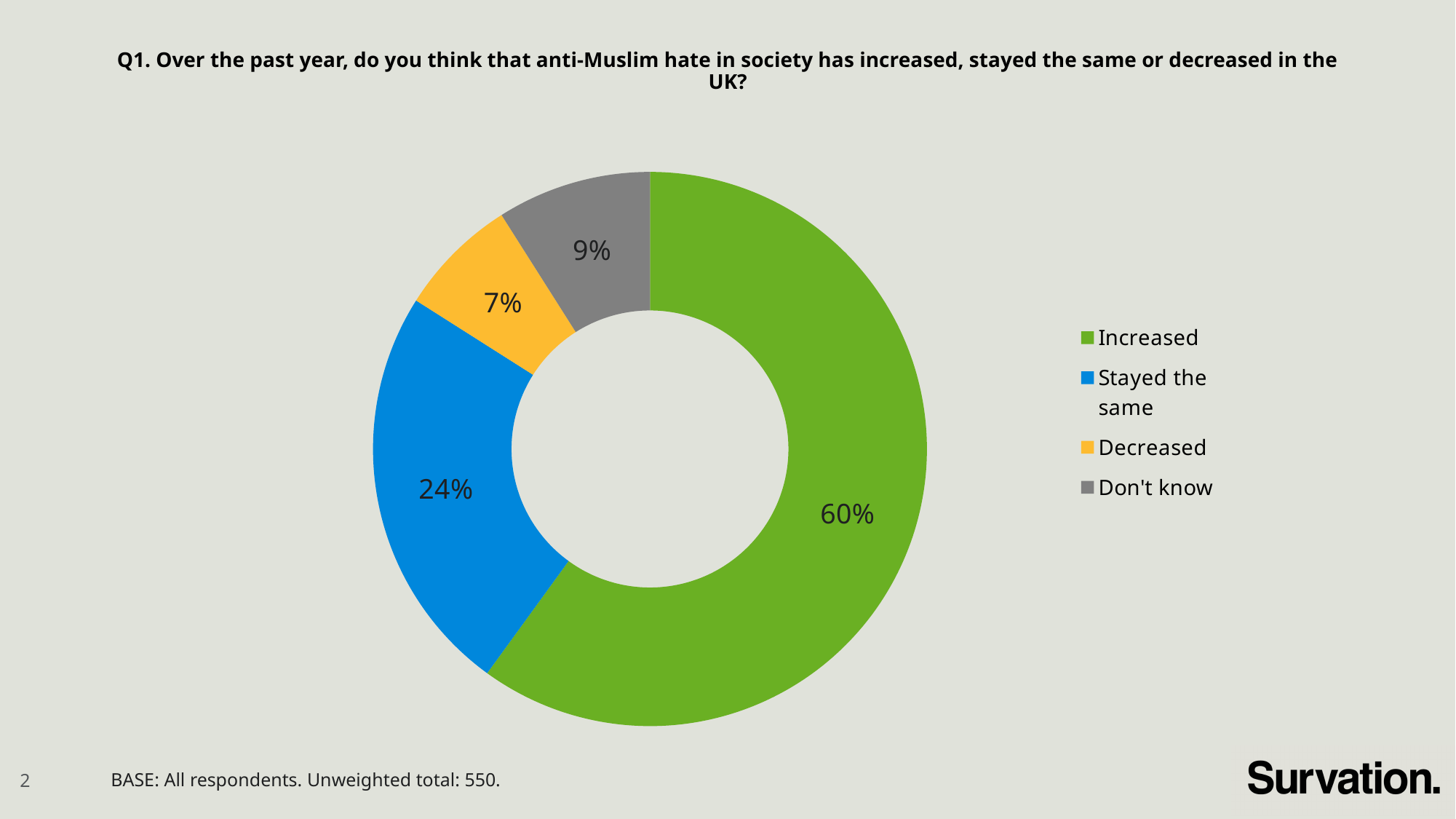
What percentage of respondents said anti-Muslim hate has decreased? 7% What percentage of respondents said anti-Muslim hate has increased? 60% What colour represents 'Stayed the same' in the chart? Blue Which response has the largest share of the chart? Increased What percentage of respondents answered 'Don't know'? 9% Which is larger, the share for 'Don't know' or the share for 'Decreased'? Don't know What is the difference in percentage points between 'Increased' and 'Stayed the same'? 36 How many categories does the chart show? 4 What kind of chart is shown on the slide? Doughnut (pie) chart Which response has the smallest share of the chart? Decreased What percentage of respondents said anti-Muslim hate stayed the same? 24% What is the unweighted total of respondents stated in the base note? 550